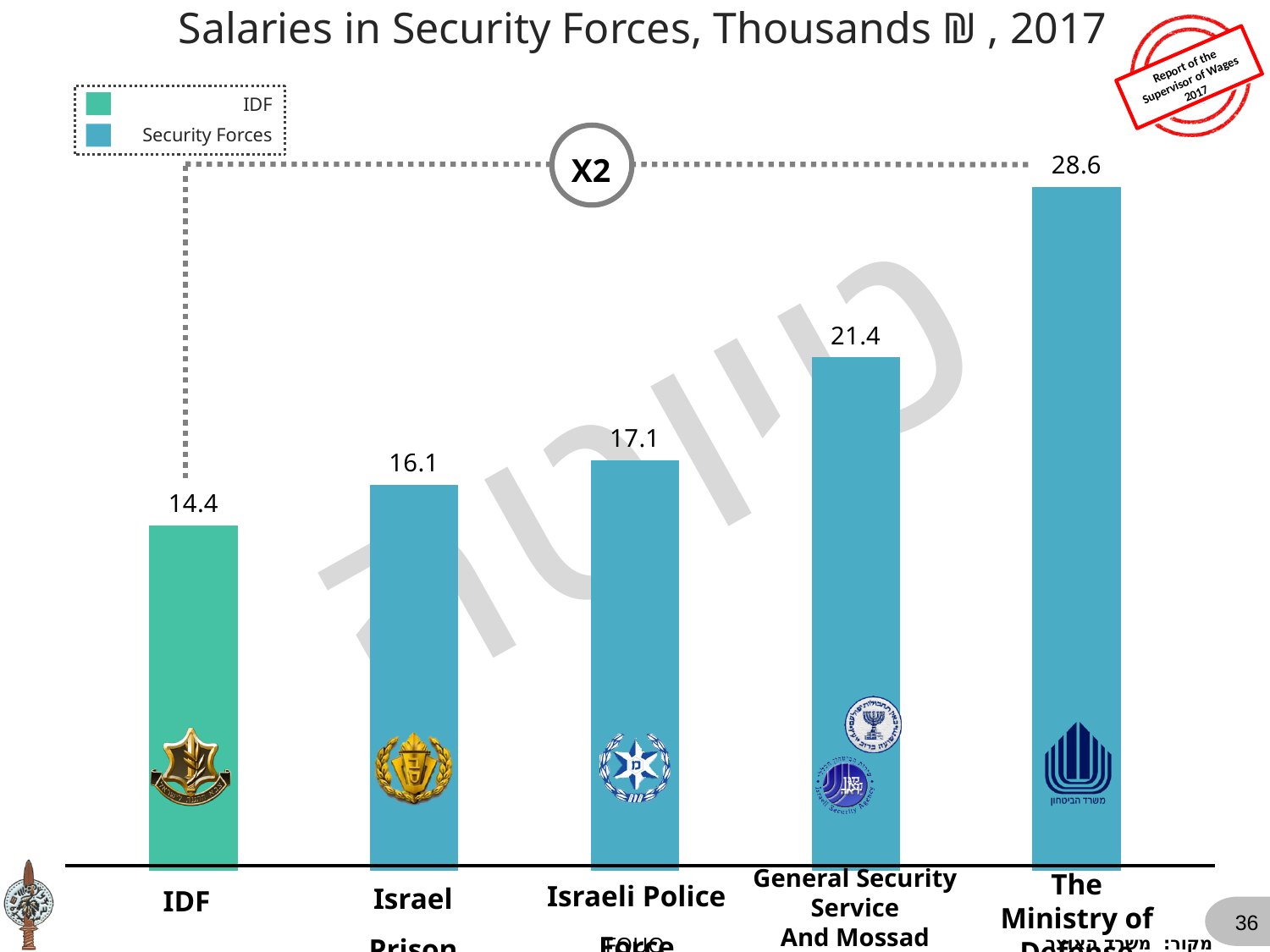
What is the value for the rightmost bar, The Ministry of Defense? 28.6 What is the difference between the values for the Israeli Police Force and the Israel Prison bar? 1.0 What is the value for the General Security Service And Mossad? 21.4 What is the value for IDF? 14.4 How many bars are shown in the chart? 5 Which is larger, the value for the General Security Service And Mossad or the value for the Israeli Police Force? General Security Service And Mossad What is the difference between the values for The Ministry of Defense and IDF? 14.2 What kind of chart is shown on the slide? Bar chart How many entries does the legend list? 2 Which category has the highest value? The Ministry of Defense Which category has the lowest value? IDF What is the value for the Israeli Police Force? 17.1